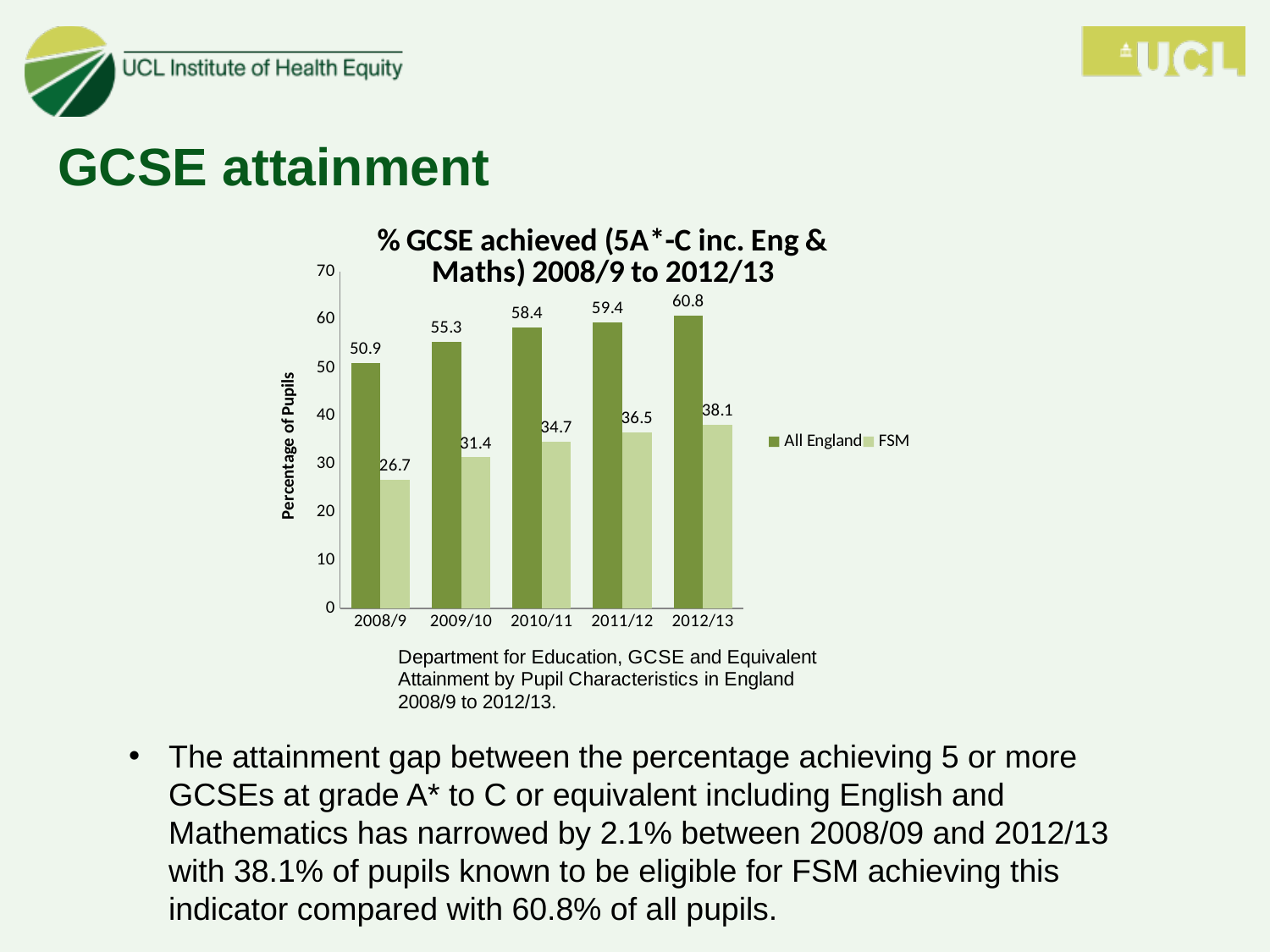
Which year has the highest All England value? 2012/13 Do the FSM values rise or fall from 2008/9 to 2012/13? rise How many years are shown on the x axis? 5 What is the difference between the All England and FSM values in 2008/9? 24.2 What is the All England value for 2008/9? 50.9 What is the FSM value for 2010/11? 34.7 How many series does the legend list? 2 Which is larger, the FSM value for 2011/12 or the FSM value for 2009/10? 2011/12 What is the difference between the All England and FSM values in 2012/13? 22.7 Which year has the lowest FSM value? 2008/9 What is the FSM value for 2012/13? 38.1 What kind of chart is shown? bar chart